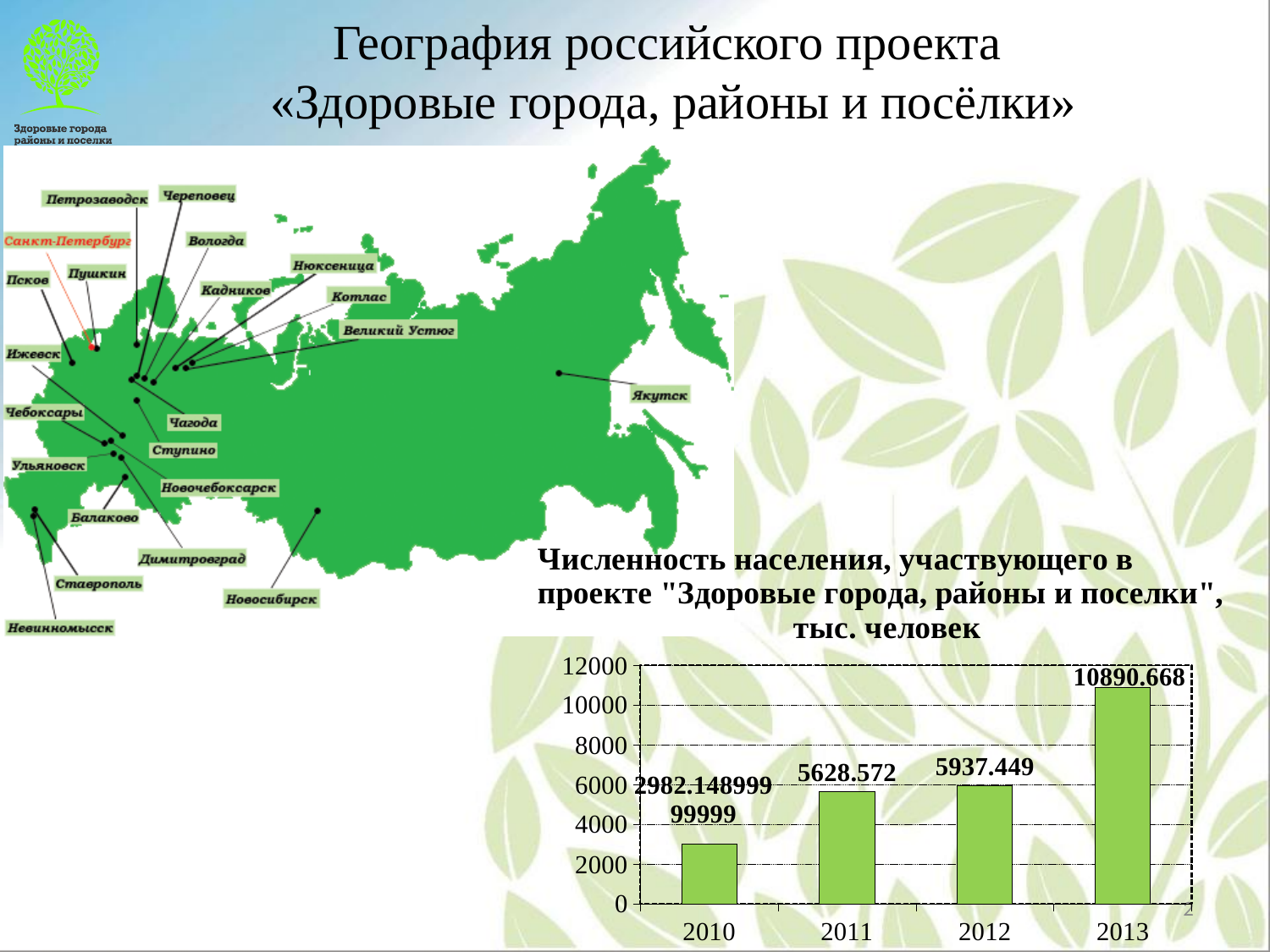
What is the value for 2012 in the population chart? 5937.449 What is the value for 2011 in the population chart? 5628.572 What is the value for 2013 in the chart "Численность населения, участвующего в проекте"? 10890.668 Which year has the highest value in the population chart? 2013 Do the values in the population chart rise or fall from 2010 to 2013? rise What kind of chart is used to show the population participating in the project? bar chart Which is larger in the population chart, the value for 2011 or for 2012? 2012 Which year has the lowest value in the population chart? 2010 What is the difference between the 2013 and 2012 values in the population chart? 4953.219 How many years are shown on the x axis of the population chart? 4 Is the value for 2013 in the population chart greater or less than 10000? greater Is the value for 2010 in the population chart greater or less than 4000? less